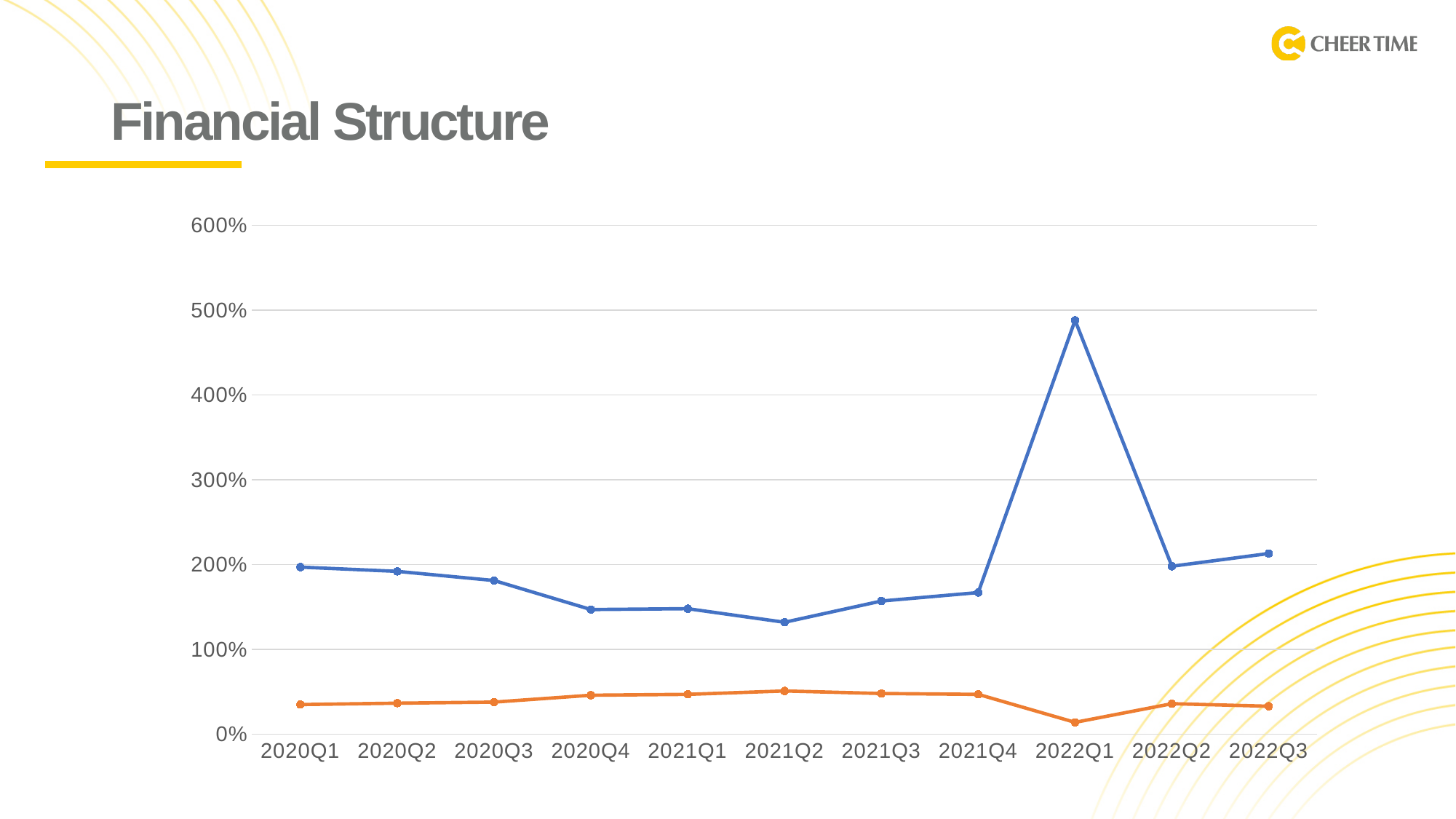
Does the blue line rise or fall from 2020Q1 to 2020Q4? fall In which quarter does the blue line reach its lowest value? 2021Q2 Is the value of the blue line at 2022Q1 greater or less than 400%? greater Is the value of the orange line at 2021Q2 greater or less than 100%? less How many quarters are shown along the x axis of the chart? 11 Is the value of the blue line at 2021Q2 greater or less than 200%? less What is the title of the slide containing the chart? Financial Structure At 2022Q1, which line has the larger value, the blue line or the orange line? the blue line How many lines are plotted on the chart? 2 In which quarter does the blue line reach its highest value? 2022Q1 What kind of chart is shown on the slide? Line chart In which quarter does the orange line reach its lowest value? 2022Q1